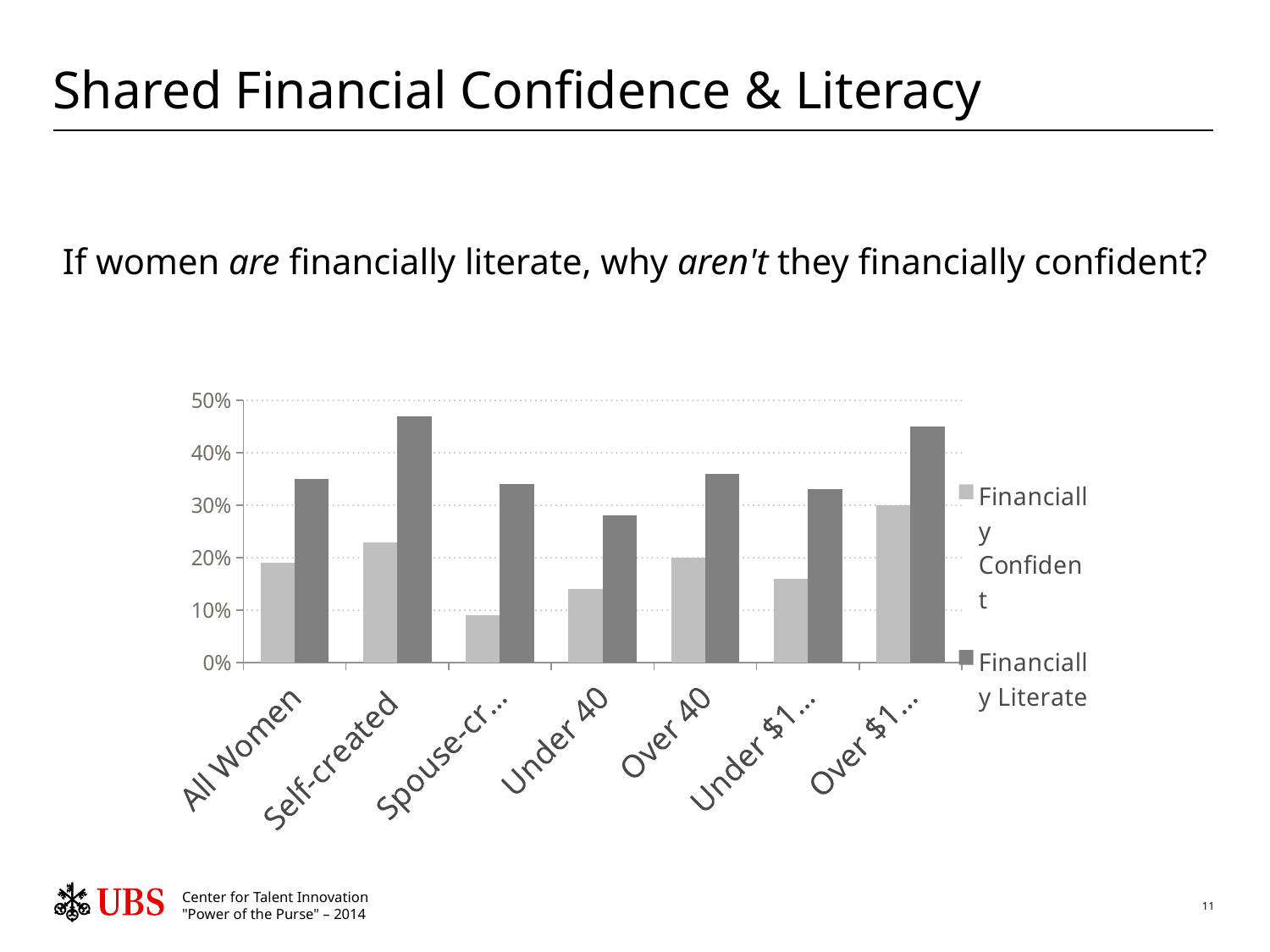
For All Women, which is larger: the Financially Confident value or the Financially Literate value? Financially Literate Which has the larger Financially Literate value: Self-created or Under 40? Self-created Which has the larger Financially Confident value: Under 40 or Over 40? Over 40 How many categories are plotted along the x axis of the chart? 7 How many series does the chart's legend list? 2 Is the Financially Confident value for Under 40 greater or less than 20%? less What kind of chart is shown on the slide? bar chart Which category has the lowest Financially Literate value? Under 40 Is the Financially Literate value for All Women greater or less than 30%? greater Is the Financially Literate value for Over 40 greater or less than 30%? greater Which series is shown in the lighter gray bars? Financially Confident